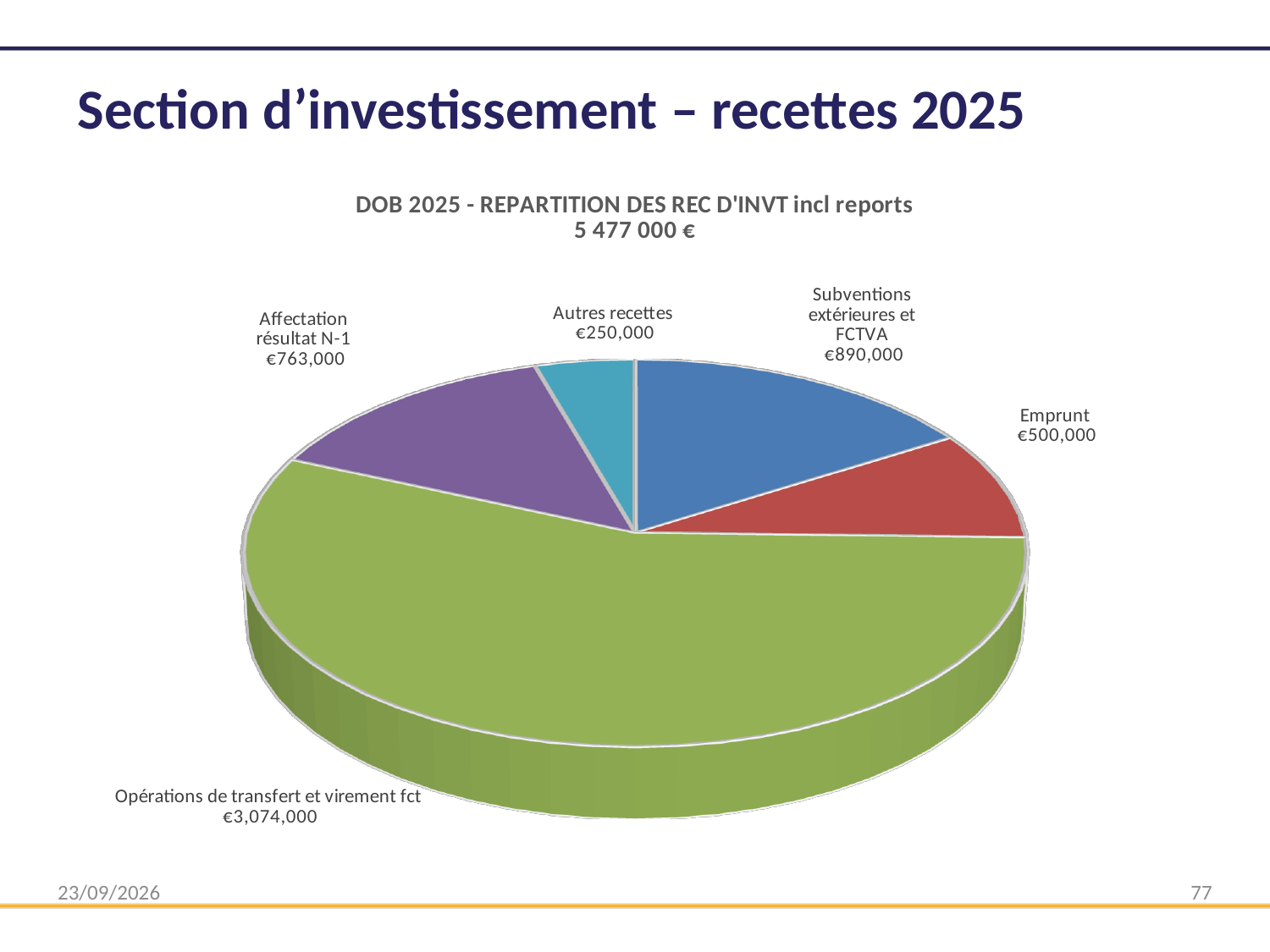
What is the value for Affectation résultat N-1? €763,000 What total amount is stated in the chart title? 5 477 000 € Which category has the smallest slice of the pie? Autres recettes What is the value for Opérations de transfert et virement fct? €3,074,000 Which is larger, Affectation résultat N-1 or Emprunt? Affectation résultat N-1 How many slices does the pie chart have? 5 What is the difference between Subventions extérieures et FCTVA and Emprunt? €390,000 What is the value for Subventions extérieures et FCTVA? €890,000 Which category has the largest slice of the pie? Opérations de transfert et virement fct What type of chart is shown on the slide? Pie chart What is the value for Autres recettes? €250,000 What is the value for Emprunt? €500,000